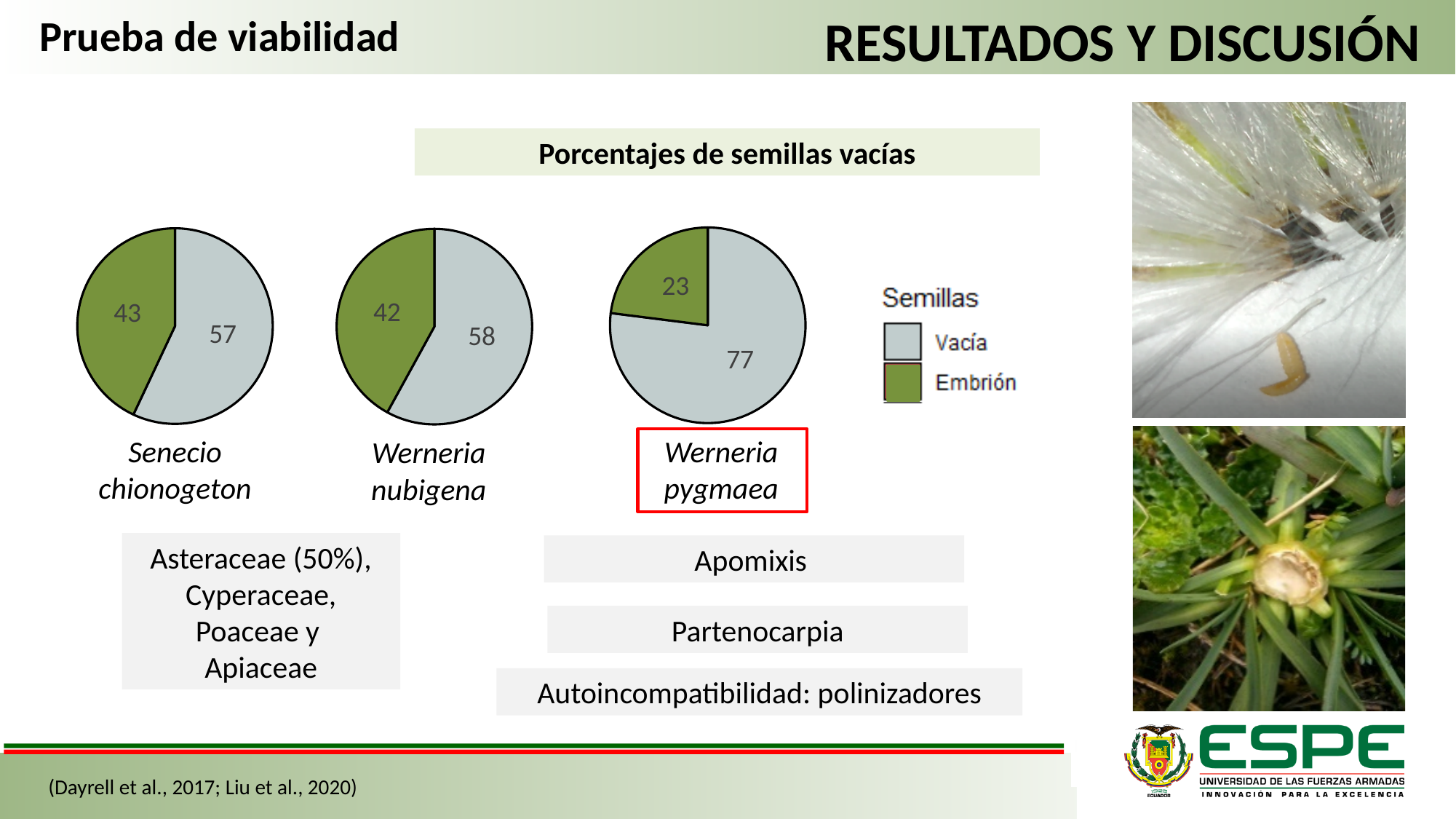
How many entries does the Semillas legend list? 2 In the Senecio chionogeton pie chart, what is the value for Vacía? 57 In the Senecio chionogeton pie chart, which slice is larger, Vacía or Embrión? Vacía How many pie charts are shown on the slide? 3 What kind of chart is used to show the Porcentajes de semillas vacías? Pie chart In the Werneria pygmaea pie chart, what is the value for Embrión? 23 In the Werneria pygmaea pie chart, what is the value for Vacía? 77 In the Werneria nubigena pie chart, what is the value for Embrión? 42 Across the three pie charts, which species has the lowest Embrión value? Werneria pygmaea Across the three pie charts, which species has the highest Vacía value? Werneria pygmaea In the Senecio chionogeton pie chart, what is the difference between the Vacía and Embrión values? 14 In the Werneria pygmaea pie chart, what is the difference between the Vacía and Embrión values? 54